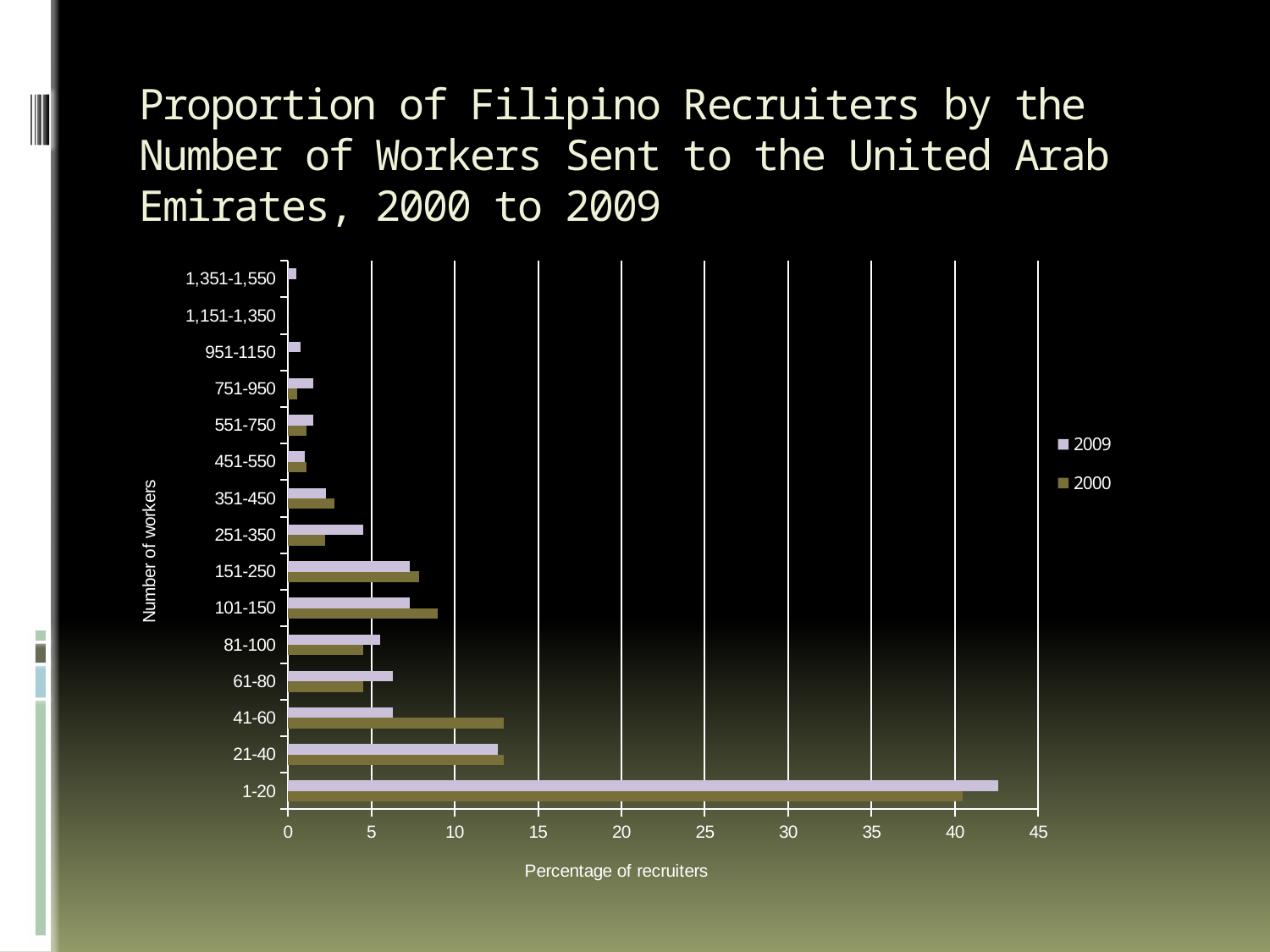
For the 251-350 category, which series has the larger value, 2009 or 2000? 2009 How many series does the legend list? 2 What is the label of the horizontal axis? Percentage of recruiters How many worker-number categories are shown on the vertical axis? 15 For the 41-60 category, which series has the larger value, 2009 or 2000? 2000 What kind of chart is shown on the slide? bar chart Which category has the highest percentage of recruiters for 2000? 1-20 Is the 2009 value for the 1-20 category greater or less than 40? greater Is the 2009 value for the 41-60 category greater or less than 10? less Which category has the highest percentage of recruiters for 2009? 1-20 Is the 2000 value for the 41-60 category greater or less than 10? greater What is the label of the vertical axis? Number of workers